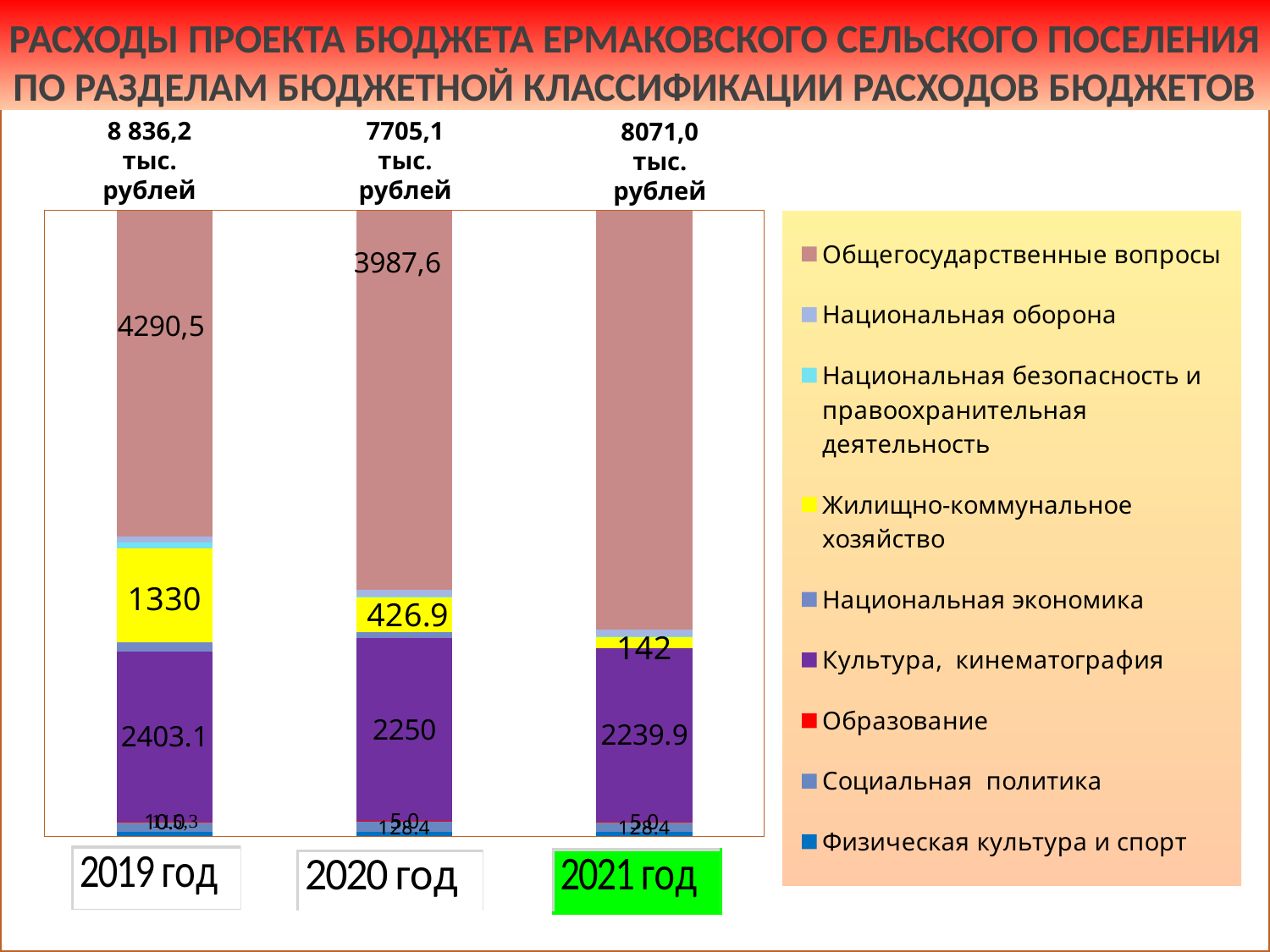
What is the total shown for the 2019 год bar? 8 836,2 тыс. рублей How many bars (years) are plotted in the chart? 3 How many series does the legend list? 9 Does the value of Жилищно-коммунальное хозяйство rise or fall from 2019 год to 2021 год? fall What is the value of Общегосударственные вопросы for 2019 год? 4290,5 What is the value of Культура, кинематография for 2020 год? 2250 Which year has the larger value for Общегосударственные вопросы, 2019 год or 2020 год? 2019 год What is the value of Общегосударственные вопросы for 2020 год? 3987,6 What kind of chart is shown on the slide? stacked bar chart What is the value of Жилищно-коммунальное хозяйство for 2021 год? 142 What is the difference between the Жилищно-коммунальное хозяйство values for 2019 год and 2020 год? 903.1 What is the value of Жилищно-коммунальное хозяйство for 2019 год? 1330